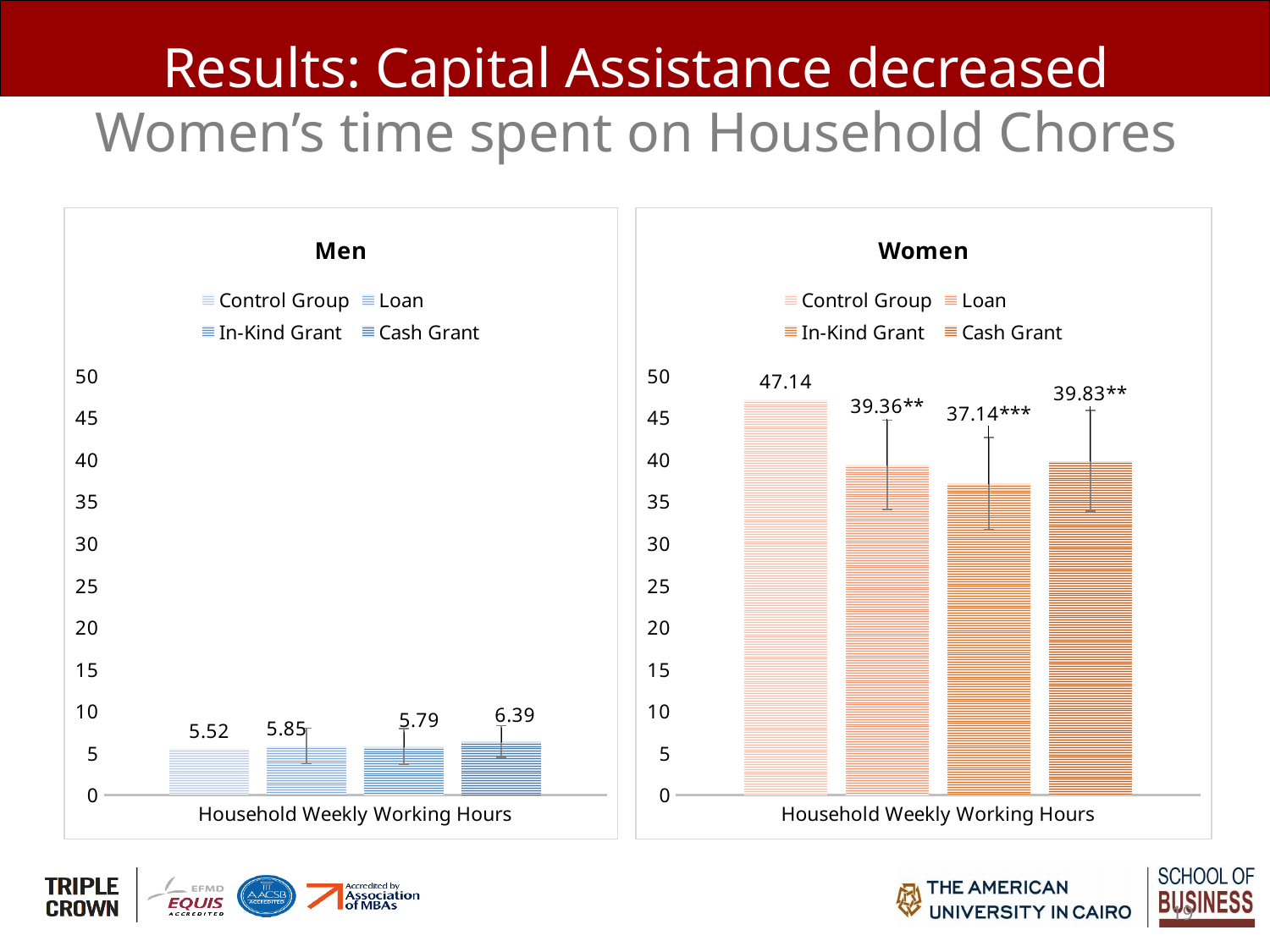
In the Women chart, which group has the highest household weekly working hours? Control Group In the Women chart, what is the value for the Control Group? 47.14 In the Women chart, is the value for the Control Group greater or less than 45? greater In the Women chart, which group has the lowest household weekly working hours? In-Kind Grant In the Women chart, what is the value labelled for the In-Kind Grant group? 37.14*** In the Men chart, what is the difference between the Cash Grant value and the Control Group value? 0.87 How many series does the legend of the Women chart list? 4 In the Women chart, what is the difference between the Control Group value and the In-Kind Grant value? 10 In the Men chart, which group has the highest value? Cash Grant In the Men chart, what is the value for the Control Group? 5.52 In the Men chart, what is the value for the Cash Grant group? 6.39 In the Men chart, which is larger, the Loan value or the In-Kind Grant value? Loan